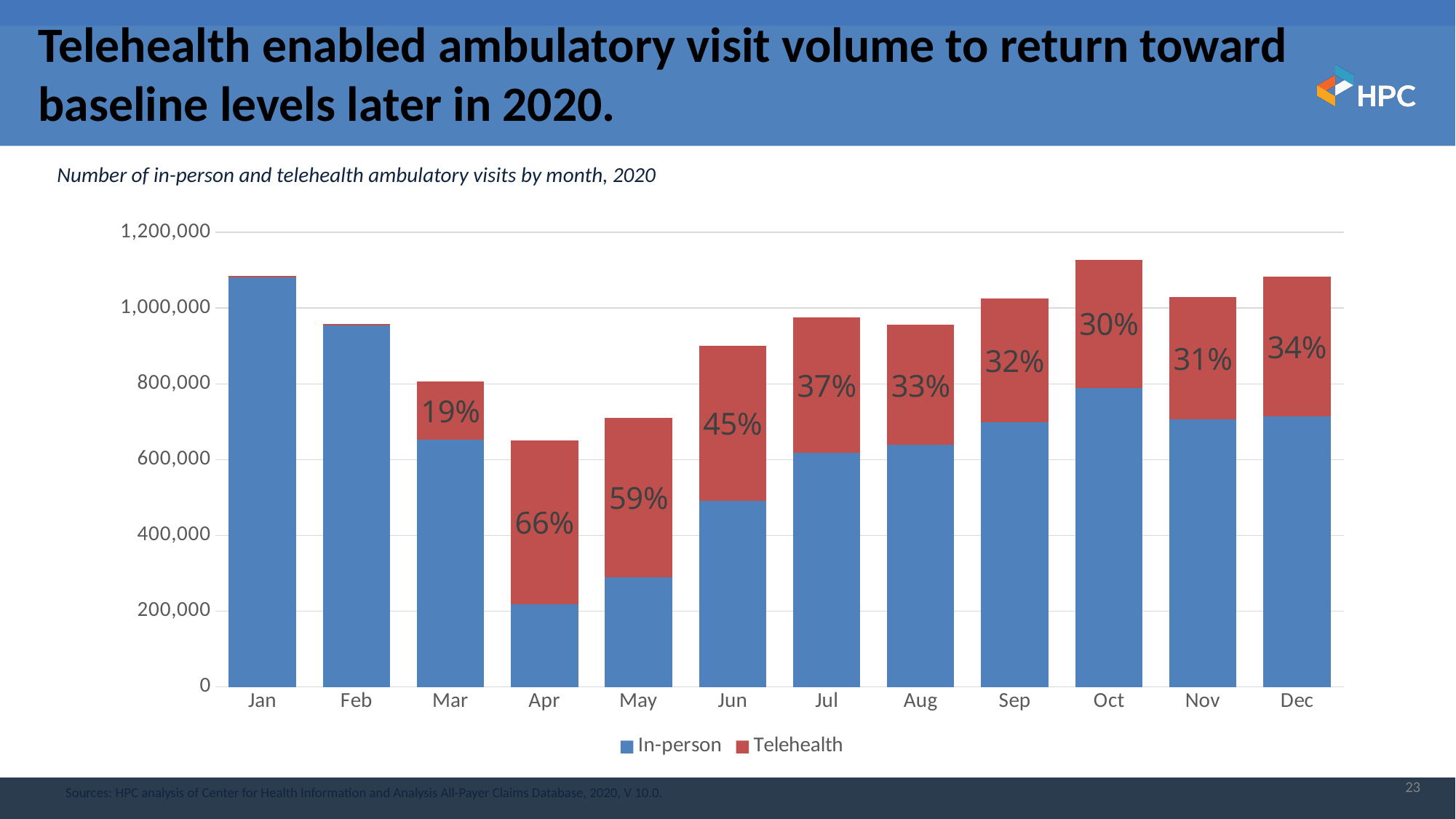
Is the total number of visits for Jan greater or less than 1,000,000? greater What percentage label is shown on the Telehealth segment for Apr? 66% What is the difference between the Telehealth percentage labels for May and Jun? 14% Is the total number of visits for Apr greater or less than 800,000? less Which month has the lowest Telehealth percentage label among the labelled months? Mar Which month has a larger Telehealth percentage label, Jul or Sep? Jul How many series does the legend list? 2 What percentage label is shown on the Telehealth segment for Oct? 30% How many months are shown on the x axis? 12 Which month has the tallest stacked bar overall? Oct Which month has the highest Telehealth percentage label? Apr What percentage label is shown on the Telehealth segment for Mar? 19%